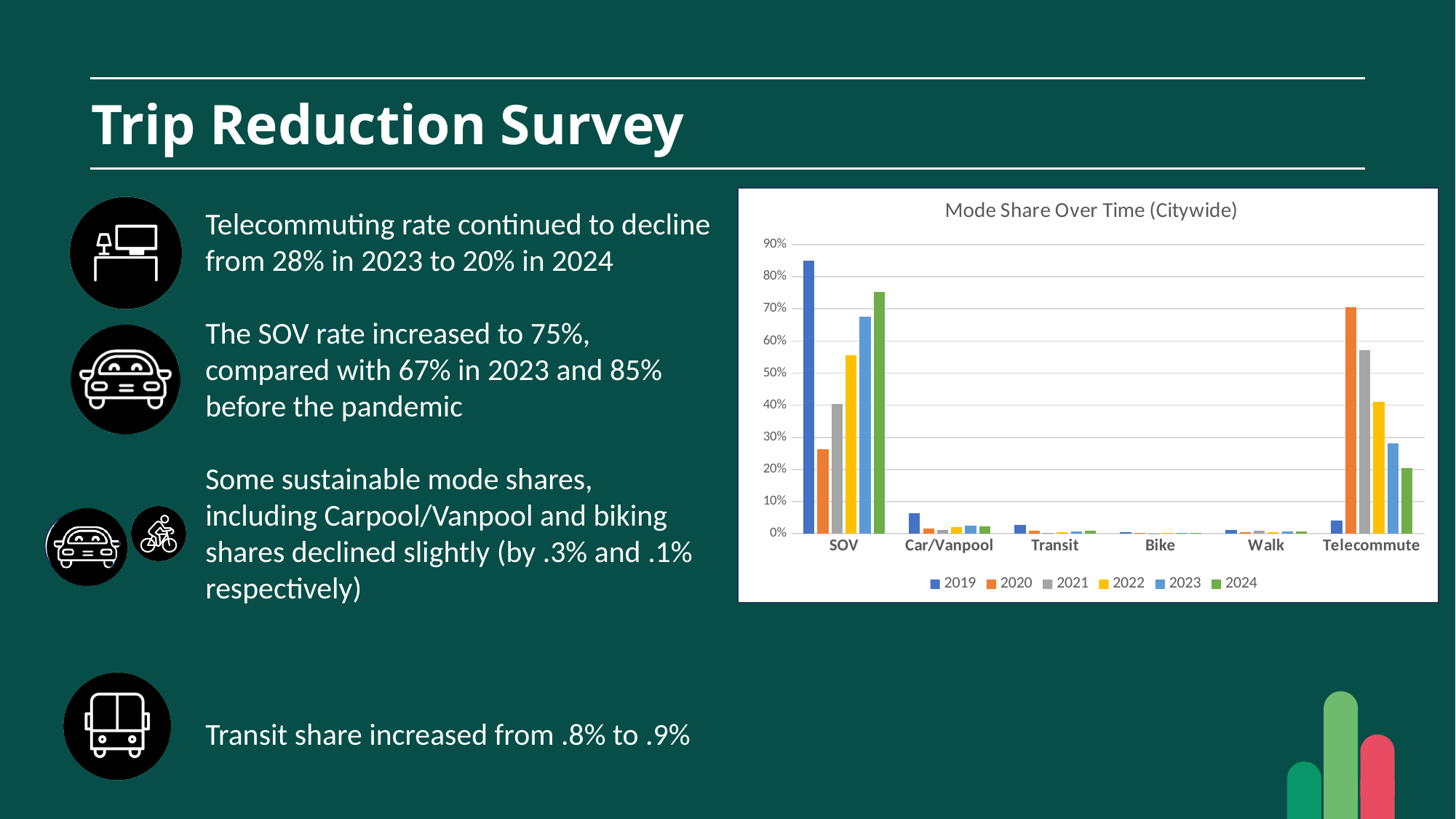
Is the SOV value for 2020 greater or less than 30%? less Which is larger, the SOV share for 2023 or for 2024? 2024 What kind of chart is shown on the slide? Bar chart Do the Telecommute values rise or fall from 2020 through 2024? fall Which year has the lowest SOV mode share in the chart? 2020 Which year has the highest SOV mode share in the chart? 2019 How many series does the chart's legend list? 6 Which year has the highest Telecommute mode share in the chart? 2020 Is the Telecommute value for 2020 greater or less than 60%? greater Is the SOV value for 2019 greater or less than 80%? greater What is the title of the chart? Mode Share Over Time (Citywide) How many mode categories are shown on the x axis of the chart? 6